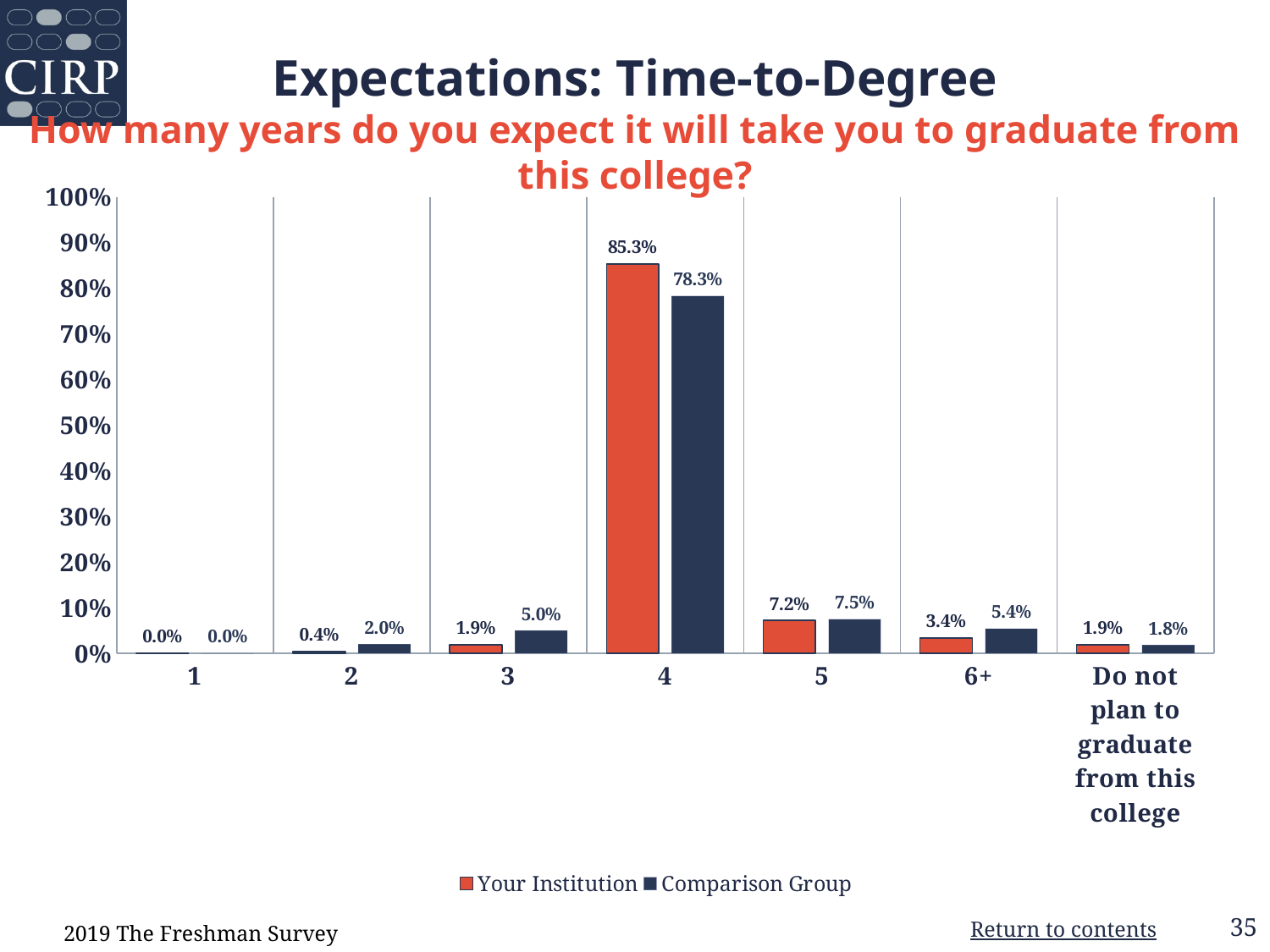
Which category has the highest value for Your Institution? 4 What is the Comparison Group value for 3 years? 5.0% What is the Your Institution value for 6+ years? 3.4% Is the Comparison Group value for 4 years greater or less than 70%? greater How many series does the legend list? 2 Which is larger for 5 years: Your Institution or Comparison Group? Comparison Group Which series is shown in dark navy in the legend? Comparison Group What is the difference between Your Institution and the Comparison Group for 4 years? 7.0% What is the Comparison Group value for 4 years? 78.3% What kind of chart is shown on the slide? bar chart What percentage of Your Institution respondents expect to graduate in 4 years? 85.3% How many categories are shown on the x axis? 7